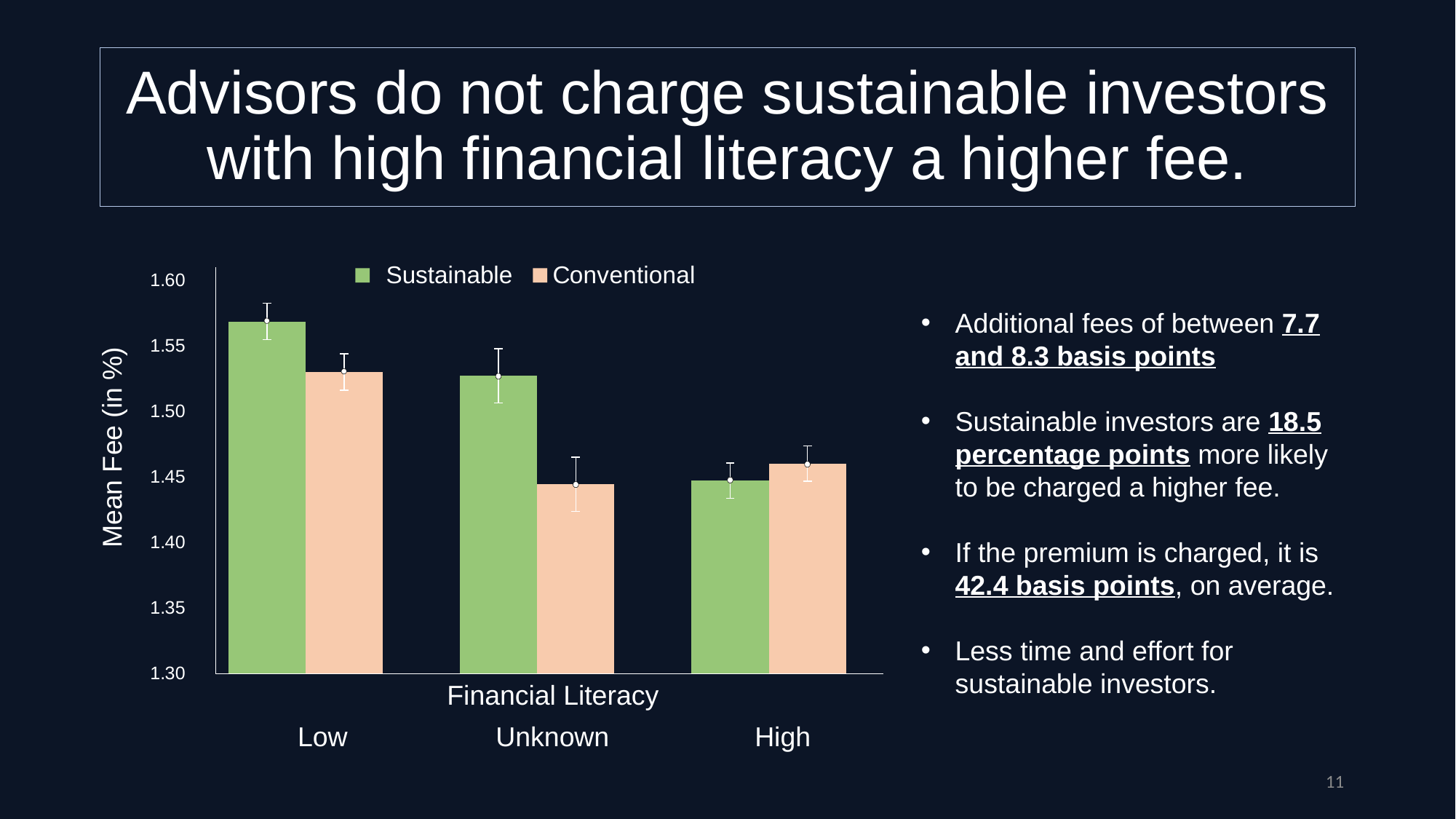
Is the Sustainable value for Low financial literacy greater or less than 1.55? greater For Unknown financial literacy, which is larger: the Sustainable or the Conventional mean fee? Sustainable What kind of chart is shown on the slide? Bar chart Is the Sustainable value for High financial literacy greater or less than 1.50? less Is the Conventional value for Unknown financial literacy greater or less than 1.50? less How many financial literacy categories are shown on the x axis? 3 What is the label of the y axis? Mean Fee (in %) Do the Sustainable values rise or fall from Low to High financial literacy? fall Which financial literacy category has the highest Sustainable bar? Low How many series does the chart legend list? 2 Which financial literacy category has the highest Conventional bar? Low